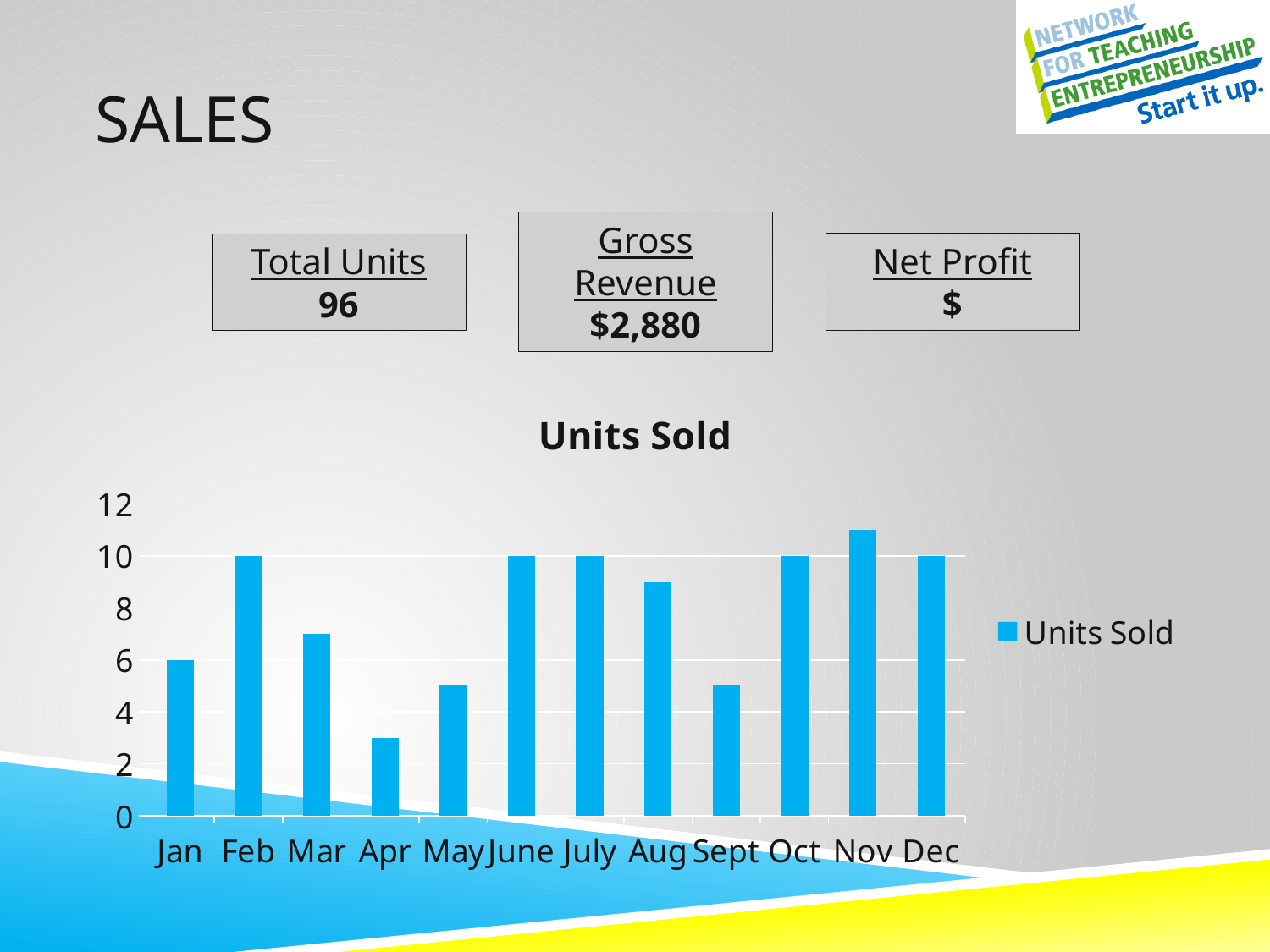
How many months are shown on the x axis of the Units Sold chart? 12 Which month has the lowest value in the Units Sold chart? Apr What is the value for Feb in the Units Sold chart? 10 Is the value for Apr in the Units Sold chart greater or less than 4? less What kind of chart is the Units Sold chart? bar chart How many series does the legend of the Units Sold chart list? 1 What is the difference between the values for Feb and Jan in the Units Sold chart? 4 What is the value for Jan in the Units Sold chart? 6 Is the value for Aug in the Units Sold chart greater or less than 8? greater Which is larger in the Units Sold chart, the value for Jan or the value for Mar? Mar Which month has the highest value in the Units Sold chart? Nov Is the value for Nov in the Units Sold chart greater or less than 10? greater